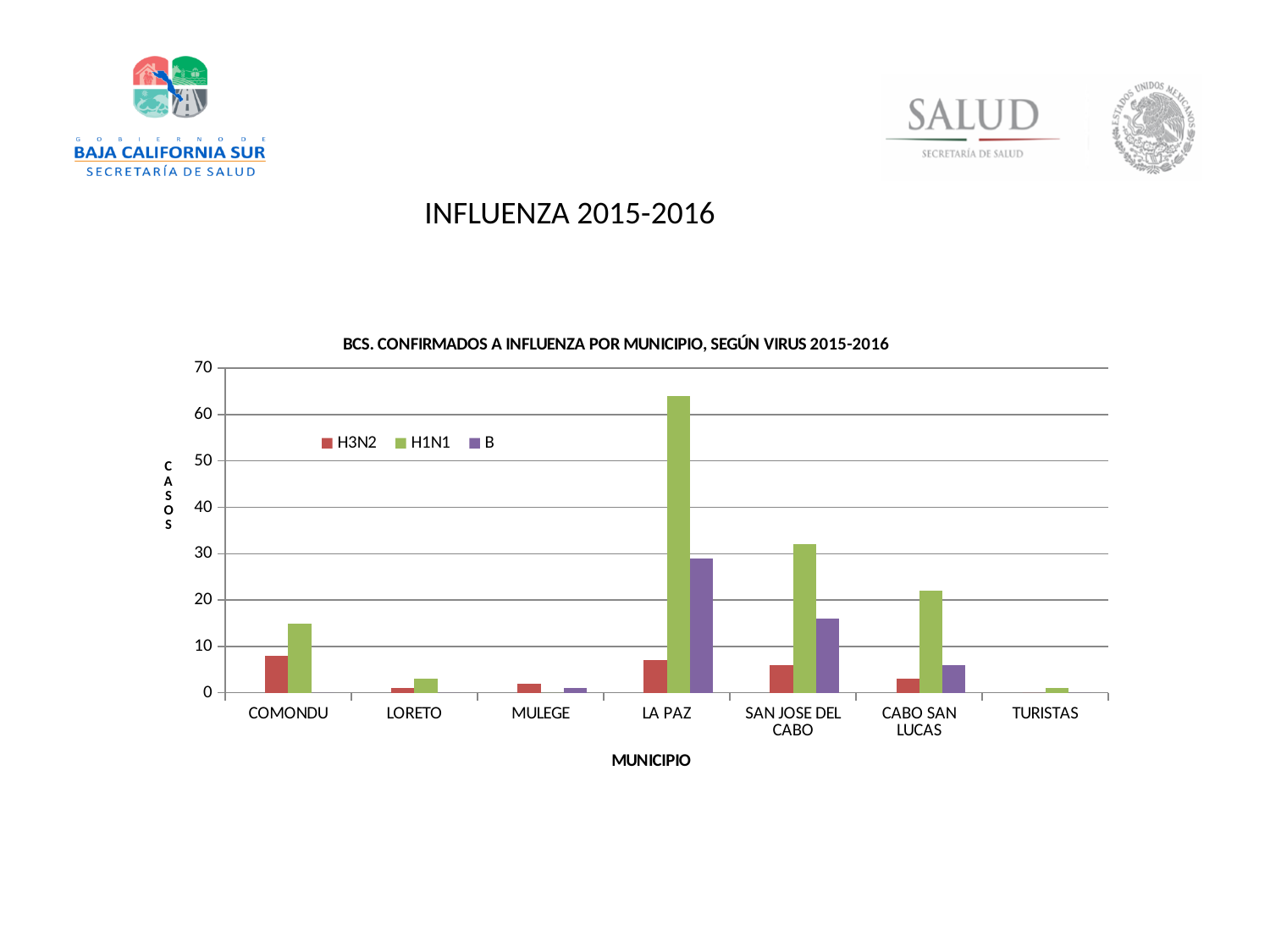
How many municipios (categories) are shown on the x axis? 7 What is the title of the chart? BCS. CONFIRMADOS A INFLUENZA POR MUNICIPIO, SEGÚN VIRUS 2015-2016 Which municipio has the highest H1N1 value? LA PAZ Is the H1N1 value for LA PAZ greater or less than 60? greater How many series does the legend list? 3 Which municipio has the highest H3N2 value? COMONDU Which municipio has the highest B value? LA PAZ What kind of chart is shown on the slide? bar chart Which is larger for SAN JOSE DEL CABO, the H1N1 value or the B value? H1N1 Is the B value for LA PAZ greater or less than 20? greater Is the H1N1 value for COMONDU greater or less than 10? greater